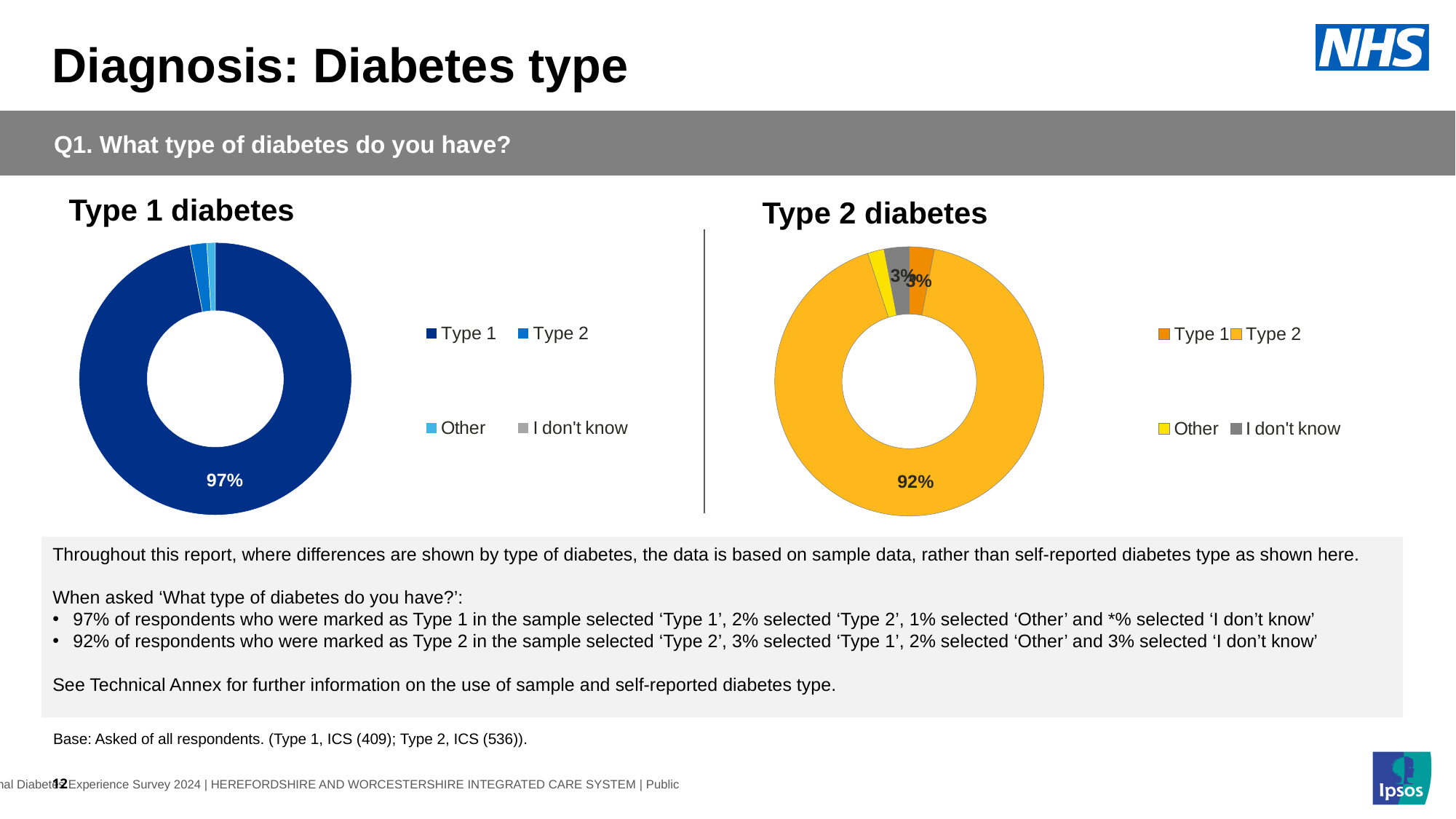
How many categories does the legend of the Type 2 diabetes chart list? 4 In the Type 2 diabetes chart, is the 'Type 2' share greater or less than 90%? greater What is the difference between the largest slice in the Type 1 diabetes chart (97%) and the largest slice in the Type 2 diabetes chart (92%)? 5 percentage points In the Type 1 diabetes chart, which category has the largest share? Type 1 In the Type 2 diabetes chart, what percentage of respondents selected 'I don't know'? 3% In the Type 1 diabetes chart, which category is shown in the darkest blue? Type 1 In the Type 2 diabetes chart, what percentage of respondents selected 'Type 2'? 92% In the Type 1 diabetes chart, what percentage of respondents selected 'Type 1'? 97% Which is larger: the 'Type 1' share in the Type 1 diabetes chart or the 'Type 2' share in the Type 2 diabetes chart? The 'Type 1' share in the Type 1 diabetes chart (97%) In the Type 2 diabetes chart, which category is shown in yellow? Other In the Type 2 diabetes chart, which category has the largest share? Type 2 What kind of chart is used for the Type 1 diabetes data? Pie (donut) chart